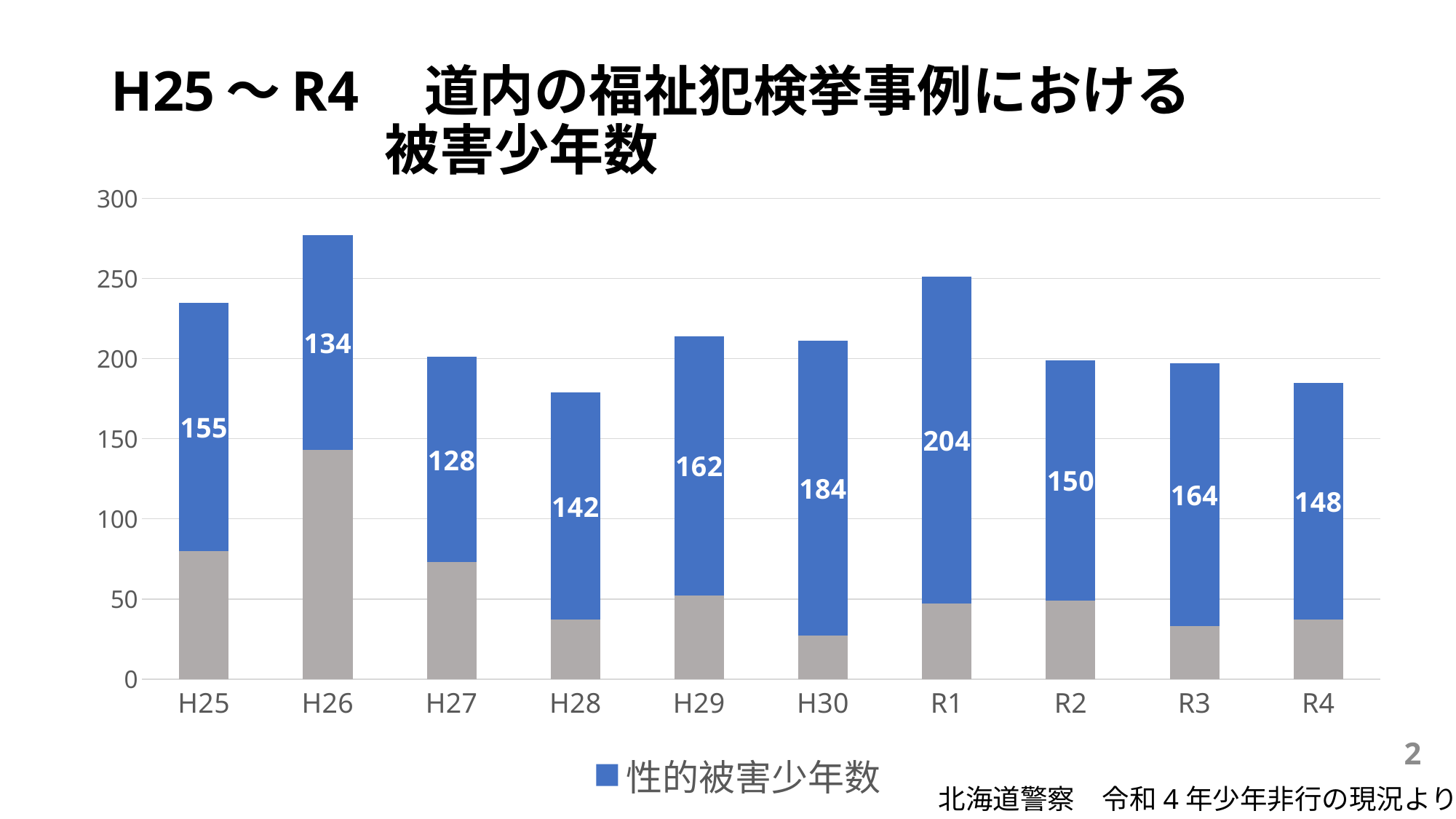
Which is larger, the 性的被害少年数 value for H29 or for R3? R3 Do the 性的被害少年数 values rise or fall from H27 to R1? rise Which year has the highest value of 性的被害少年数? R1 What is the value of 性的被害少年数 for H30? 184 How many series does the legend list? 1 Which year has the lowest value of 性的被害少年数? H27 What is the value of 性的被害少年数 for R4? 148 What is the difference between the 性的被害少年数 values for R1 and H27? 76 How many years are shown on the x axis? 10 Is the total height of the H26 bar greater or less than 250? greater Is the total height of the H28 bar greater or less than 200? less What kind of chart is shown on the slide? Stacked bar chart